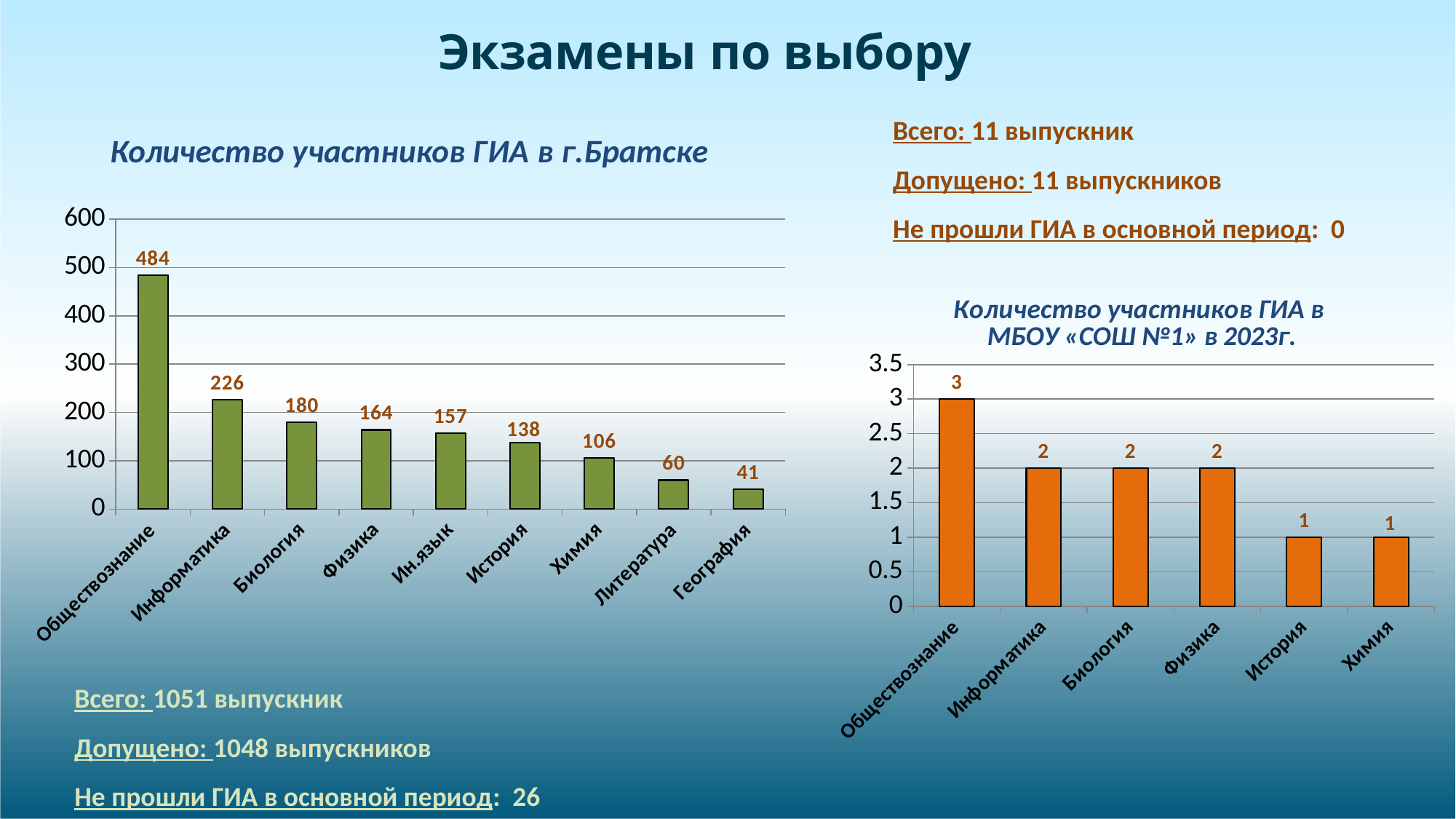
In the chart 'Количество участников ГИА в МБОУ «СОШ №1» в 2023г.', which is larger, the value for Физика or the value for История? Физика In the chart 'Количество участников ГИА в г.Братске', which subject has the highest number of participants? Обществознание In the chart 'Количество участников ГИА в МБОУ «СОШ №1» в 2023г.', how many subjects are shown on the x axis? 6 In the chart 'Количество участников ГИА в г.Братске', what is the value for Информатика? 226 In the chart 'Количество участников ГИА в г.Братске', what is the value for Литература? 60 In the chart 'Количество участников ГИА в г.Братске', how many subjects are shown on the x axis? 9 In the chart 'Количество участников ГИА в г.Братске', which subject has the lowest number of participants? География In the chart 'Количество участников ГИА в МБОУ «СОШ №1» в 2023г.', what is the value for Обществознание? 3 In the chart 'Количество участников ГИА в г.Братске', do the values rise or fall from left to right along the x axis? fall In the chart 'Количество участников ГИА в г.Братске', what is the difference between the values for Биология and Физика? 16 What kind of chart is 'Количество участников ГИА в МБОУ «СОШ №1» в 2023г.'? bar chart What colour are the bars in the chart 'Количество участников ГИА в МБОУ «СОШ №1» в 2023г.'? orange